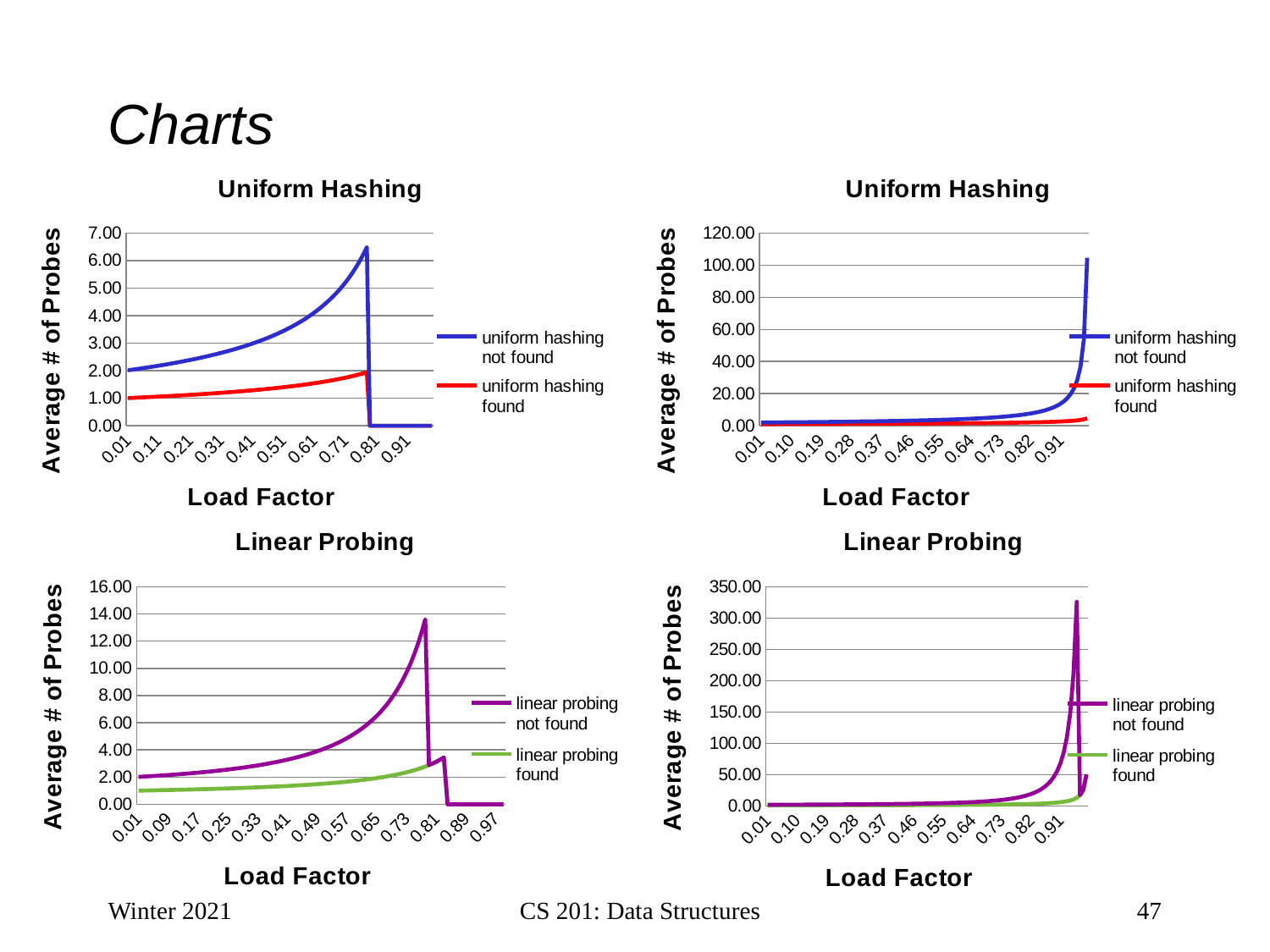
In the bottom-left 'Linear Probing' chart, is the peak value of 'linear probing found' greater or less than 4.00? less How many series does the legend of the top-left 'Uniform Hashing' chart list? 2 In the top-right 'Uniform Hashing' chart, does the 'uniform hashing not found' series rise or fall as the load factor increases from 0.01 to 0.91? rise What are the two legend entries of the bottom-left 'Linear Probing' chart? linear probing not found; linear probing found In the bottom-left 'Linear Probing' chart, is the peak value of 'linear probing not found' greater or less than 12.00? greater What is the x-axis title of the bottom-right 'Linear Probing' chart? Load Factor What kind of chart is the top-left 'Uniform Hashing' chart? line chart In the bottom-right 'Linear Probing' chart, is the peak value of 'linear probing not found' greater or less than 300.00? greater In the bottom-left 'Linear Probing' chart, which series reaches the higher peak? linear probing not found In the top-left 'Uniform Hashing' chart, which series is higher at load factor 0.51? uniform hashing not found